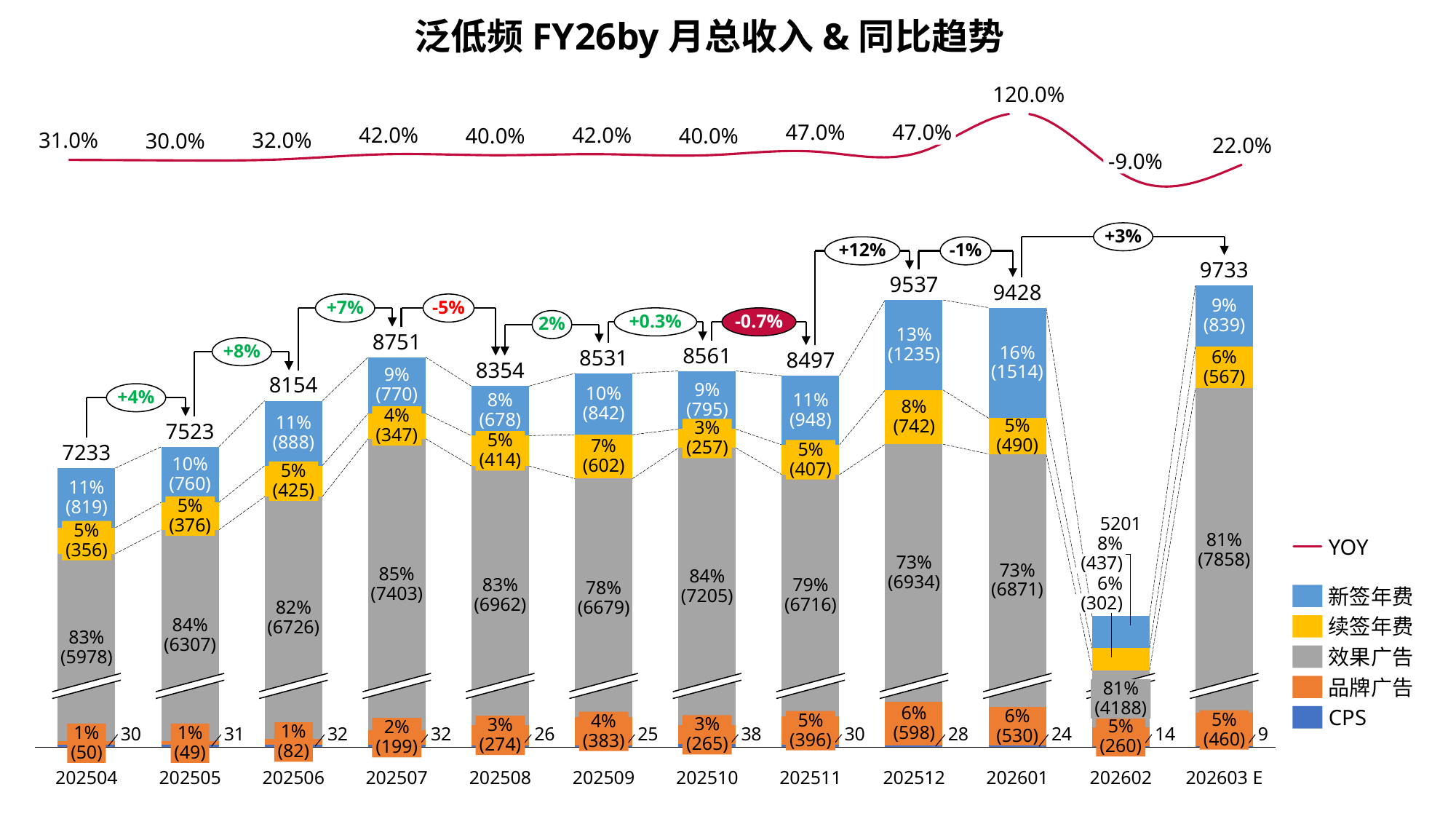
What is the YOY value for 202601? 120.0% How many months are shown on the x axis? 12 What is the total revenue shown for 202512? 9537 What is the 效果广告 value for 202507? 7403 Which month has the lowest YOY value? 202602 What is the difference between the total revenue for 202512 and 202601? 109 What is the 新签年费 value for 202601? 1514 Which month has the lowest total revenue? 202602 What percentage share of the 202512 total does 新签年费 account for? 13% What kind of chart is this? Stacked bar chart with a line Which month has the highest total revenue? 202603 E Which month has the larger total revenue, 202509 or 202510? 202510